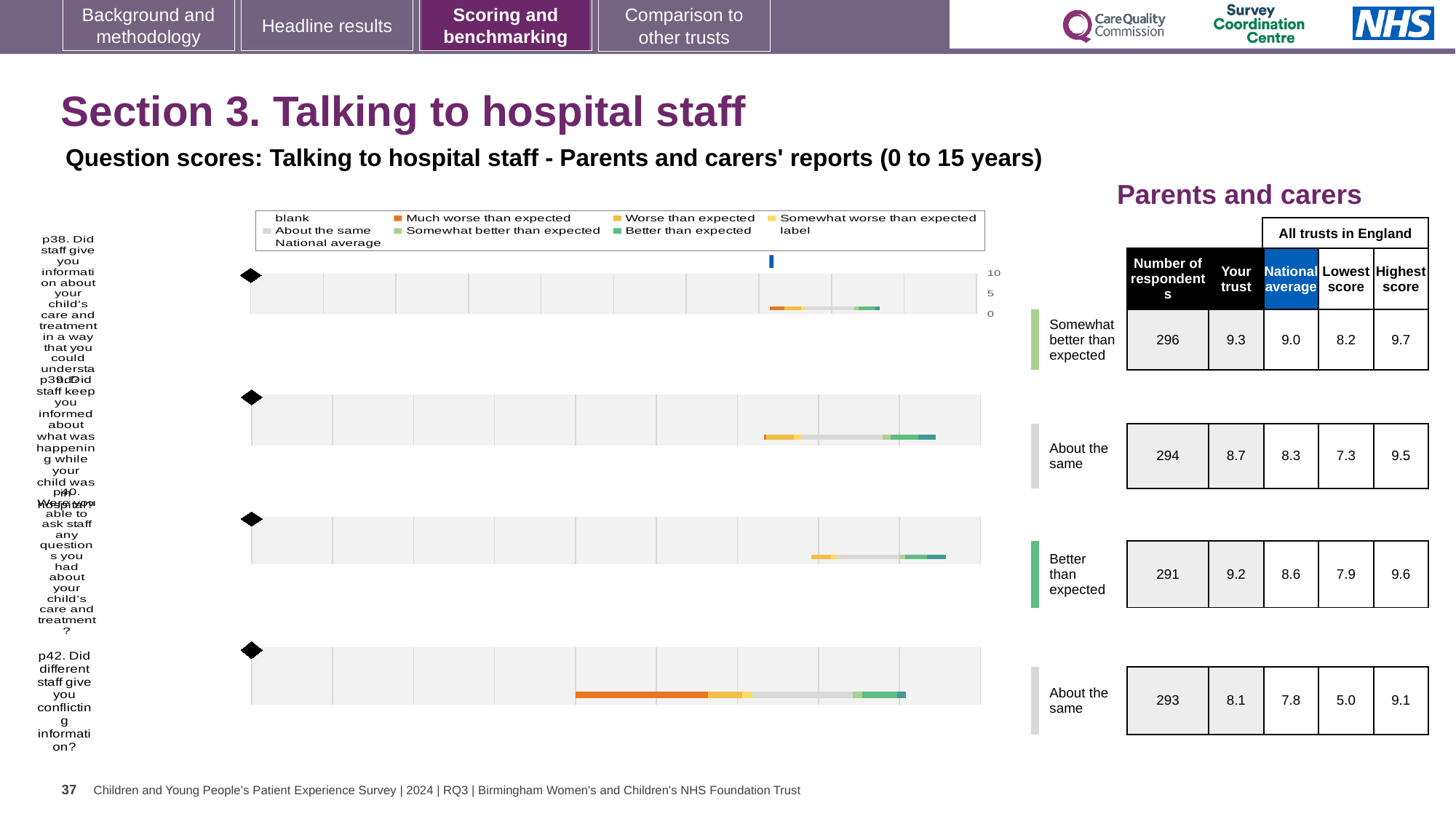
What kind of charts are the four benchmarking charts on the slide? bar chart In the table beside the charts, what is the national average for the bottom chart (p42)? 7.8 What is the highest tick value shown on the axis of the top chart? 10 How many entries does the shared legend above the charts list? 9 In the table beside the charts, what is the difference between the 'Your trust' score and the national average for the third chart (p40)? 0.6 In the table beside the charts, how many respondents answered the question for the bottom chart (p42)? 293 Which legend entry is shown in orange? Much worse than expected In the table beside the charts, which question has the lowest 'Your trust' score? p42 In the table beside the charts, is the 'Your trust' score for the second chart (p39) larger than its national average? Yes How many benchmarking bar charts are shown on the slide? 4 In the table beside the charts, which question has the highest 'Your trust' score? p38 In the table beside the charts, what is the 'Your trust' score for the top chart (p38)? 9.3